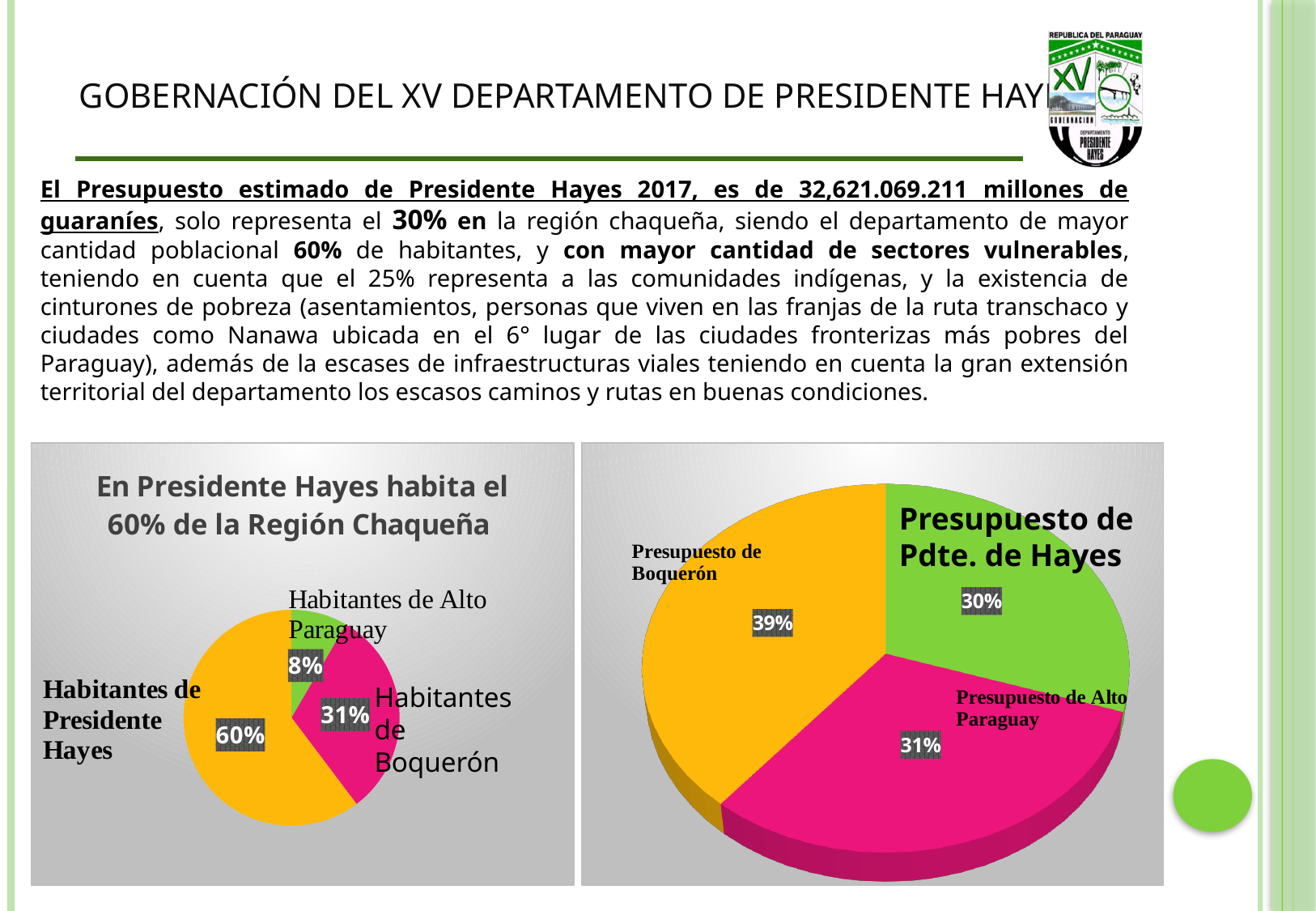
In the right chart titled 'Presupuesto de Pdte. de Hayes', what share is labelled for Presupuesto de Alto Paraguay? 31% In the left chart titled 'En Presidente Hayes habita el 60% de la Región Chaqueña', which slice is the smallest? Habitantes de Alto Paraguay In the left chart titled 'En Presidente Hayes habita el 60% de la Región Chaqueña', how many slices does the pie have? 3 In the left chart titled 'En Presidente Hayes habita el 60% de la Región Chaqueña', which slice is the largest? Habitantes de Presidente Hayes What type of chart is the right chart titled 'Presupuesto de Pdte. de Hayes'? Pie chart In the left chart titled 'En Presidente Hayes habita el 60% de la Región Chaqueña', what share is labelled for Habitantes de Alto Paraguay? 8% In the left chart titled 'En Presidente Hayes habita el 60% de la Región Chaqueña', what share is labelled for Habitantes de Boquerón? 31% In the left chart titled 'En Presidente Hayes habita el 60% de la Región Chaqueña', what is the difference in percentage points between Habitantes de Presidente Hayes and Habitantes de Boquerón? 29 percentage points In the right chart titled 'Presupuesto de Pdte. de Hayes', which is larger: the Presupuesto de Boquerón slice or the Presupuesto de Pdte. de Hayes slice? Presupuesto de Boquerón In the right chart titled 'Presupuesto de Pdte. de Hayes', what is the difference in percentage points between Presupuesto de Boquerón and Presupuesto de Pdte. de Hayes? 9 percentage points In the right chart titled 'Presupuesto de Pdte. de Hayes', which slice is the largest? Presupuesto de Boquerón In the right chart titled 'Presupuesto de Pdte. de Hayes', what share is labelled for Presupuesto de Boquerón? 39%